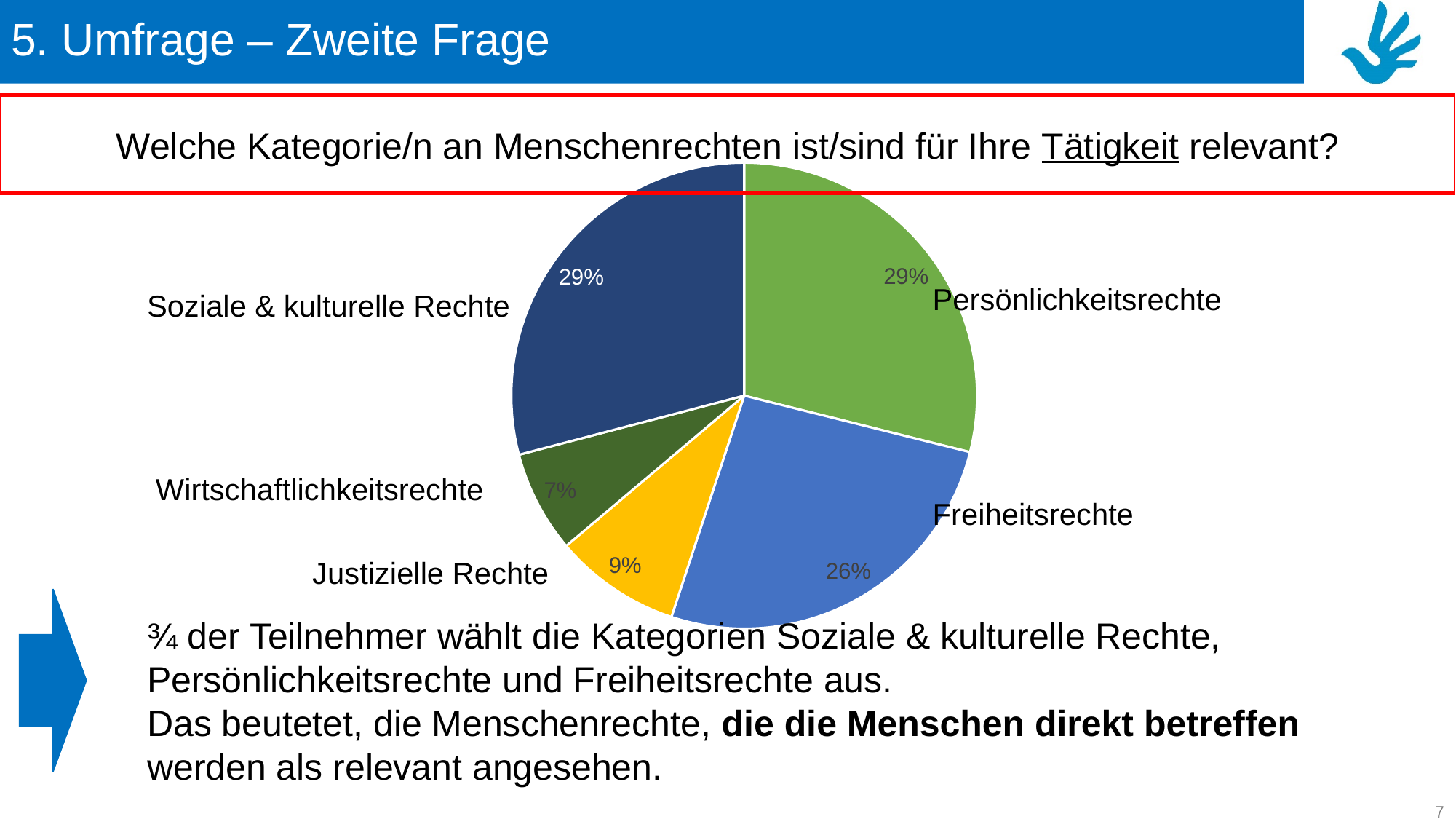
What percentage of the pie is Soziale & kulturelle Rechte? 29% What percentage of the pie is Justizielle Rechte? 9% What percentage of the pie is Freiheitsrechte? 26% What kind of chart is shown on the slide? pie chart Which slice is larger, Freiheitsrechte or Justizielle Rechte? Freiheitsrechte How many percentage points larger is the Freiheitsrechte slice than the Justizielle Rechte slice? 17 How many categories are shown in the pie chart? 5 What colour is the Justizielle Rechte slice? yellow What is the combined share of Soziale & kulturelle Rechte, Persönlichkeitsrechte and Freiheitsrechte? 84% What percentage of the pie is Persönlichkeitsrechte? 29% What percentage of the pie is Wirtschaftlichkeitsrechte? 7% Which category has the smallest slice of the pie? Wirtschaftlichkeitsrechte